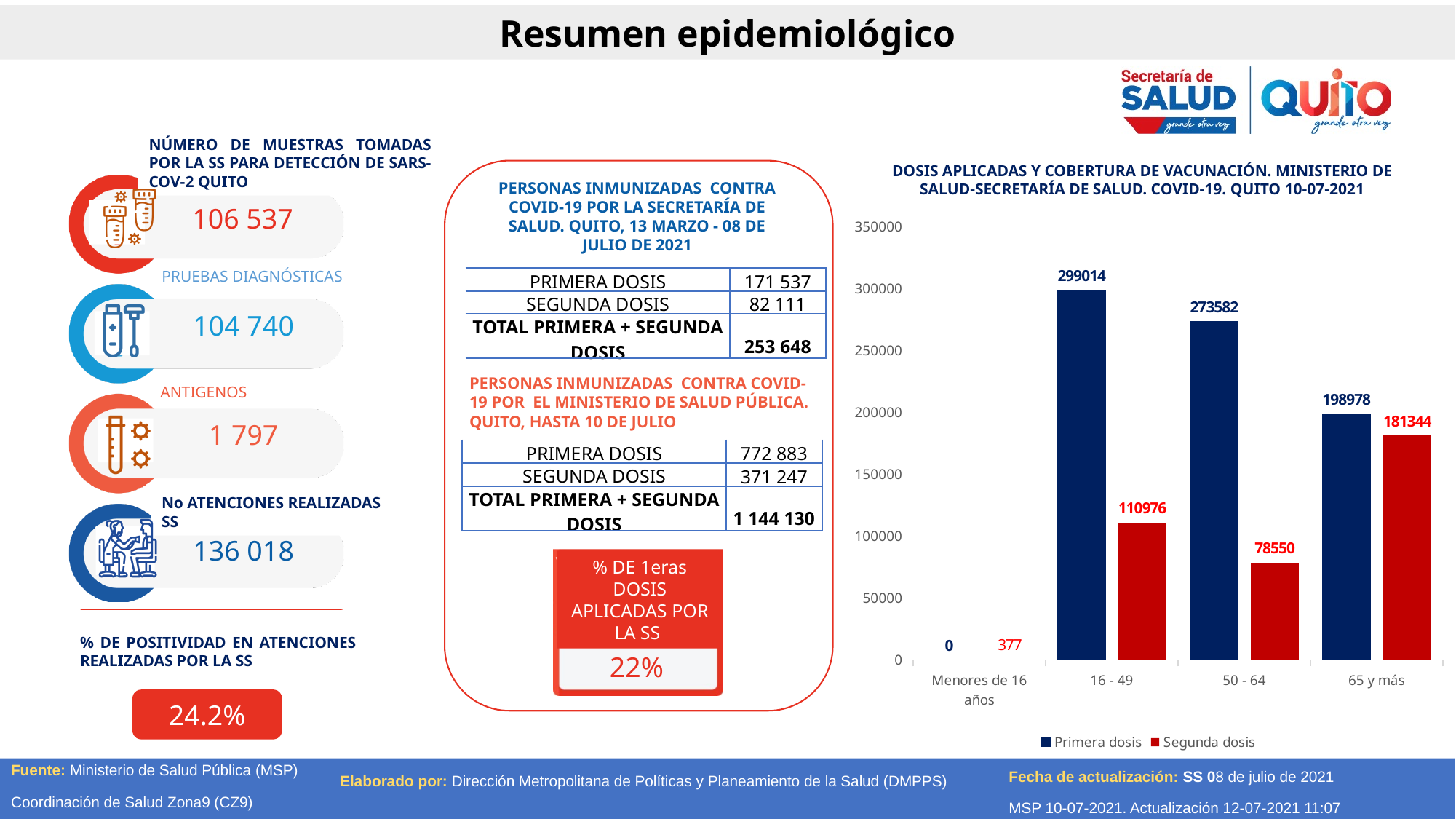
How many age groups are shown on the x axis of the chart? 4 What is the value of Segunda dosis for the Menores de 16 años group? 377 Which is larger for the 65 y más group: Primera dosis or Segunda dosis? Primera dosis What colour are the Segunda dosis bars in the chart? Red Which age group has the highest Primera dosis value? 16 - 49 What is the difference between Primera dosis and Segunda dosis for the 50 - 64 age group? 195032 What is the value of Primera dosis for the 16 - 49 age group? 299014 What kind of chart is used to show the doses applied by age group? Bar chart Is the Segunda dosis value for the 16 - 49 group greater or less than 100000? greater What is the value of Segunda dosis for the 65 y más age group? 181344 Which age group has the lowest Segunda dosis value? Menores de 16 años How many series does the chart legend list? 2